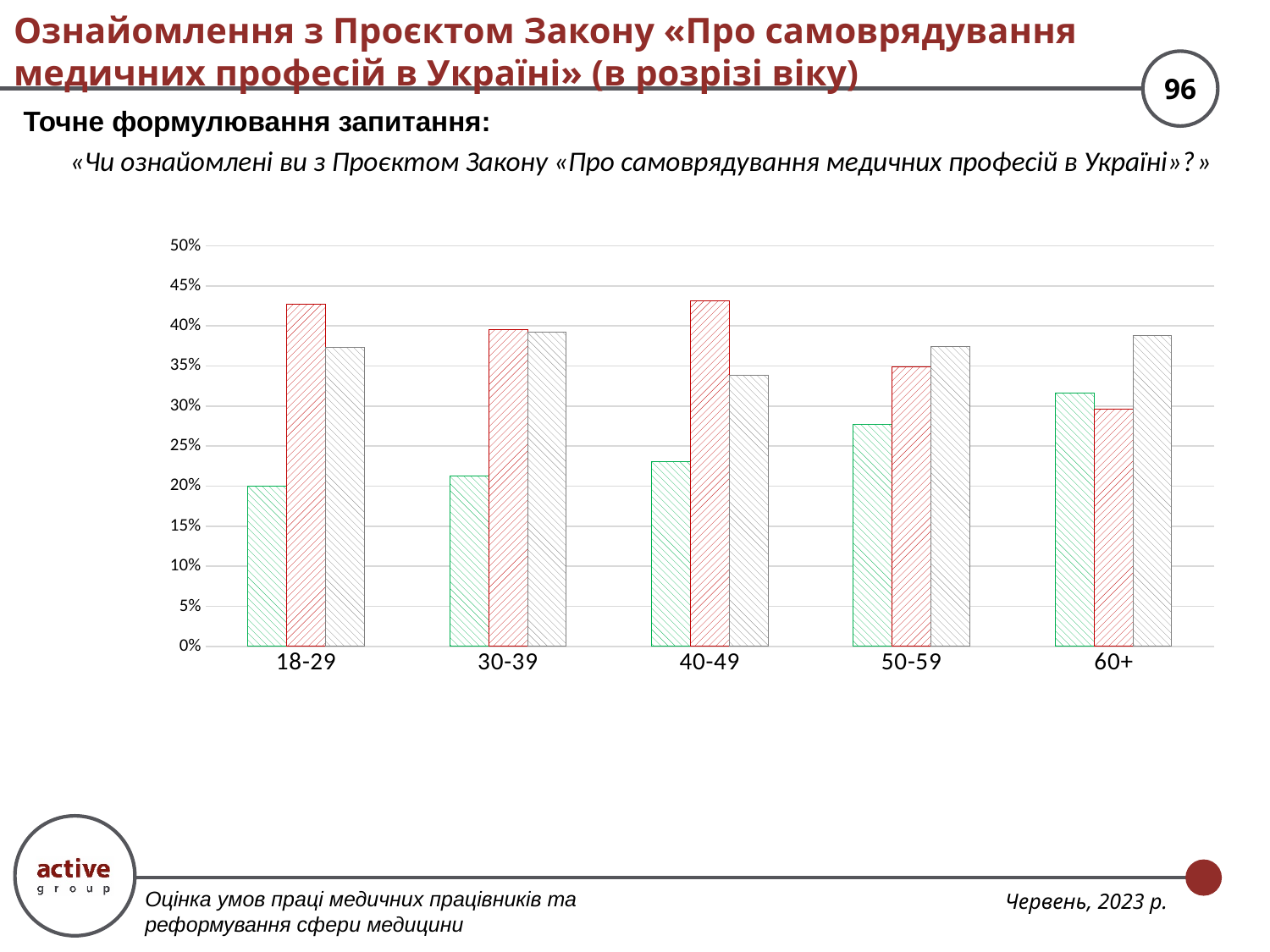
Which age group has the lowest red bar? 60+ How many age groups are shown on the x axis of the chart? 5 What kind of chart is shown on the slide? bar chart Which age group has the lowest grey bar? 40-49 How many bars are plotted for each age group in the chart? 3 Which age group has the highest green bar? 60+ Is the grey bar for the 40-49 age group greater or less than 35%? less Is the green bar for the 50-59 age group greater or less than 25%? greater Which age group has the lowest green bar? 18-29 Is the red bar for the 18-29 age group greater or less than 40%? greater In the 18-29 age group, which is larger: the red bar or the green bar? the red bar Do the green bars rise or fall as the age groups move from 18-29 to 60+? rise